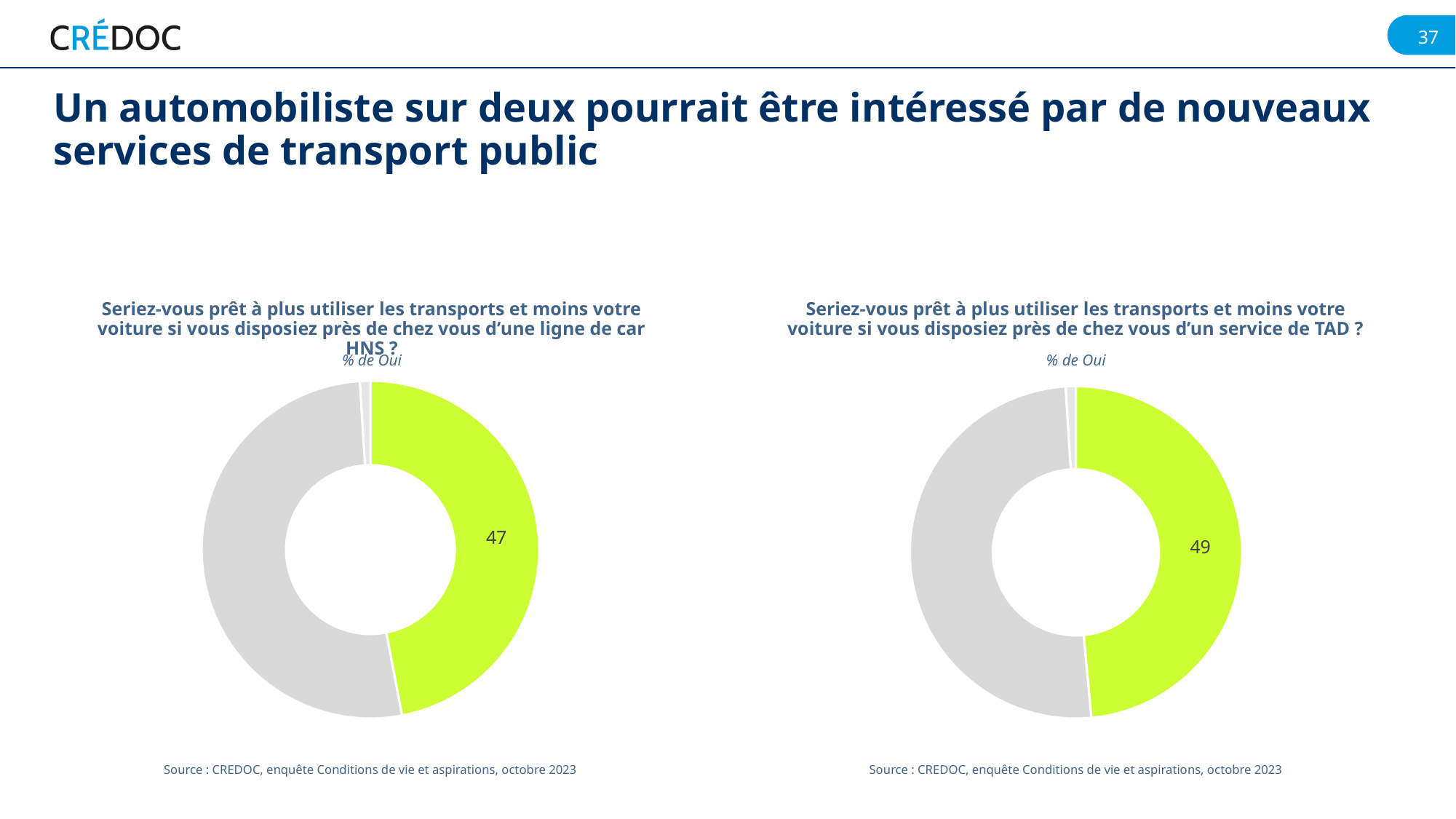
What kind of chart is the left chart (ligne de car HNS)? donut (pie) chart What is the difference between the % de Oui in the right chart (49) and the left chart (47)? 2 In the left chart, is the value for the green slice greater or less than 50? less In the left chart (ligne de car HNS), what value is shown for the green slice (% de Oui)? 47 In the right chart, is the value for the green slice greater or less than 50? less What kind of chart is the right chart (service de TAD)? donut (pie) chart In the right chart (service de TAD), what value is shown for the green slice (% de Oui)? 49 What subtitle appears under the title of each chart, indicating what the values represent? % de Oui What colour is the slice labelled 49 in the right chart? green Which chart shows the higher % de Oui: the left chart (ligne de car HNS) or the right chart (service de TAD)? the right chart (service de TAD)